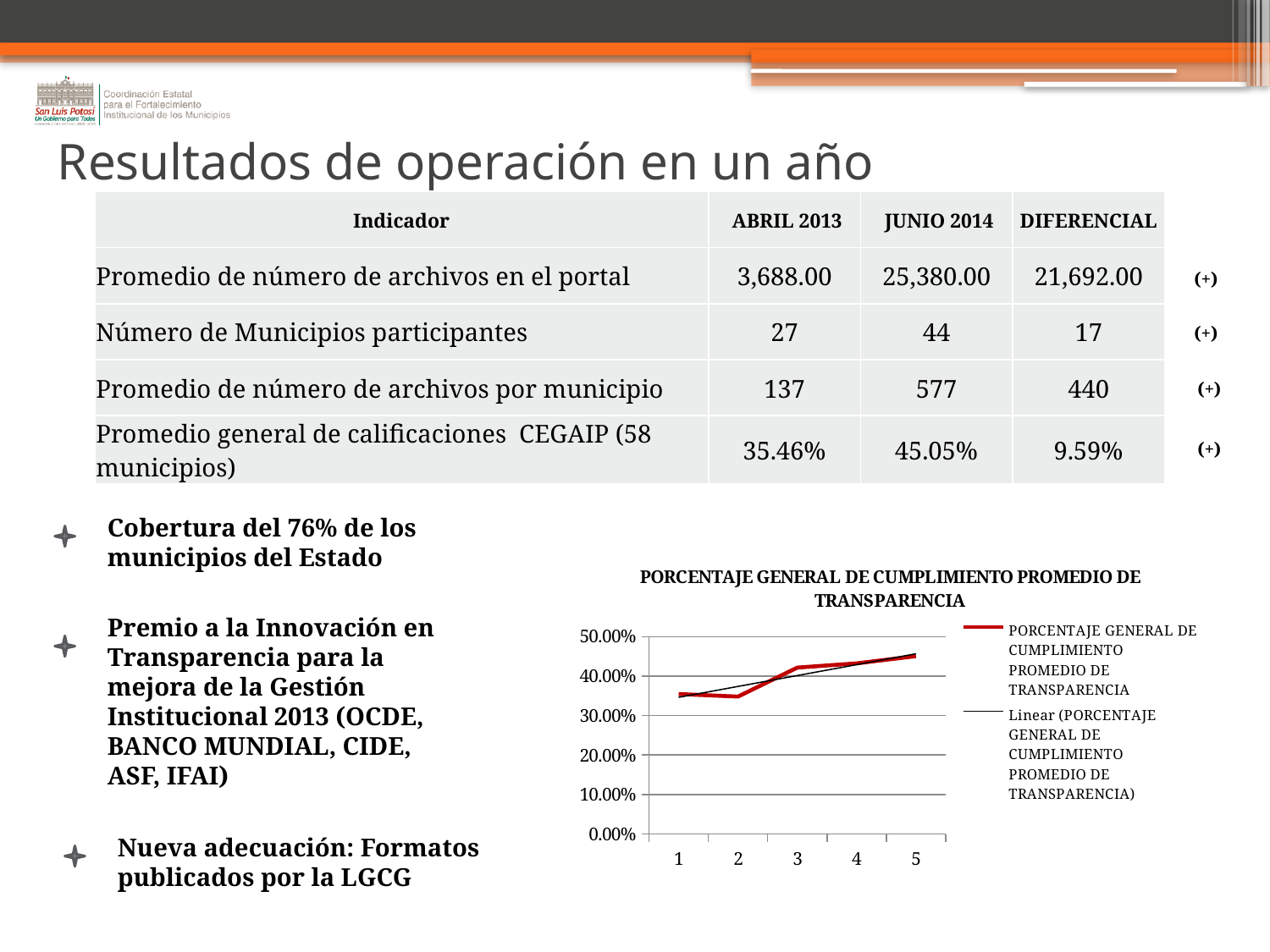
What kind of chart is shown on the slide? line chart Do the values in the chart generally rise or fall from point 1 to point 5? rise Is the value at point 1 greater or less than 40.00%? less Is the value at point 2 greater or less than 40.00%? less What is the title of the chart on the slide? PORCENTAJE GENERAL DE CUMPLIMIENTO PROMEDIO DE TRANSPARENCIA How many entries does the chart's legend list? 2 What colour is the line for PORCENTAJE GENERAL DE CUMPLIMIENTO PROMEDIO DE TRANSPARENCIA in the chart? red Which point has the highest value in the chart? 5 How many points are plotted along the x axis of the chart? 5 Is the value at point 5 greater or less than 50.00%? less Which is larger, the value at point 3 or the value at point 1? point 3